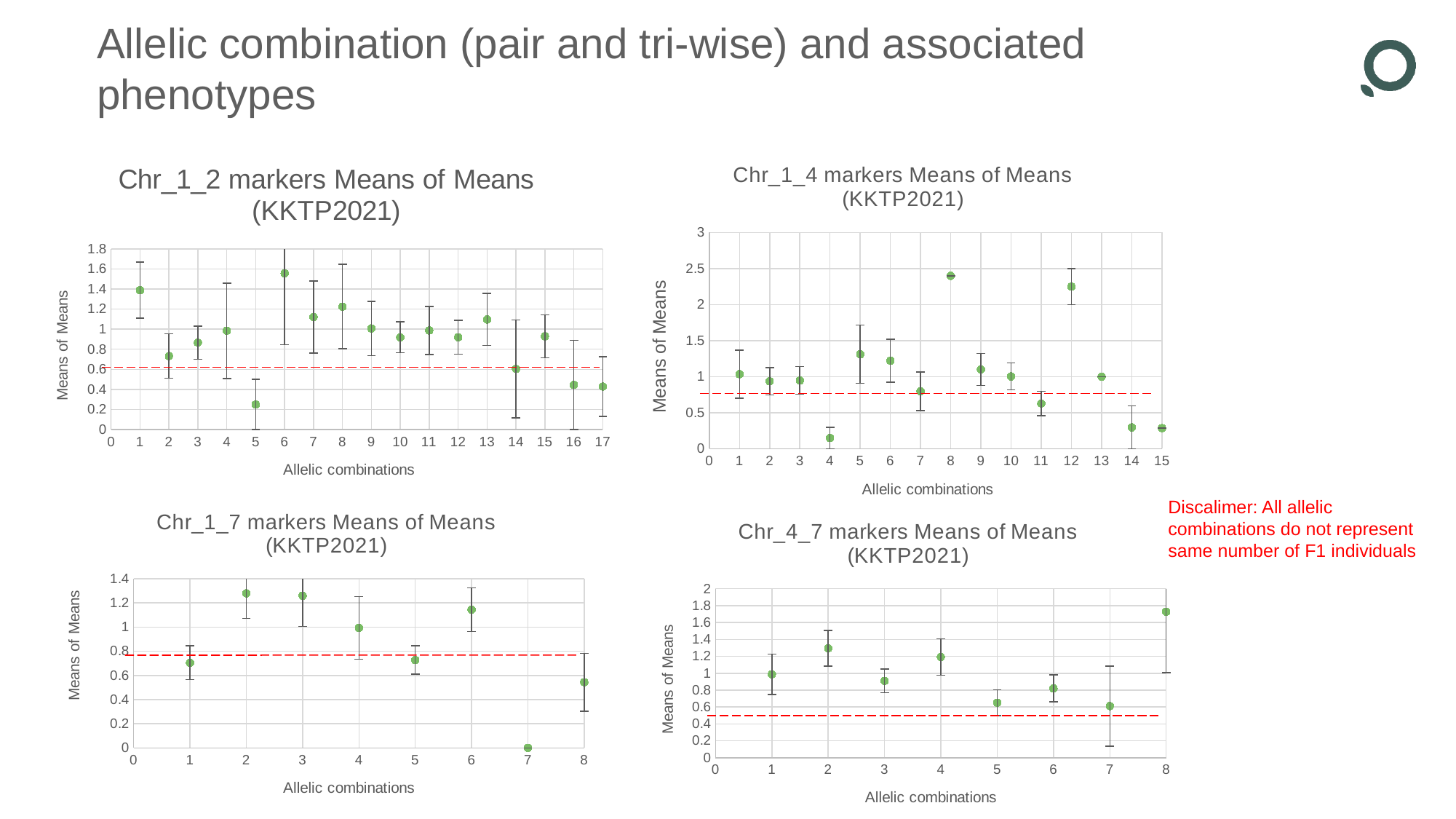
What kind of chart is the Chr_1_2 markers Means of Means (KKTP2021) chart? scatter chart How many allelic combinations are plotted in the Chr_1_7 markers Means of Means (KKTP2021) chart? 8 How many allelic combinations are plotted in the Chr_1_4 markers Means of Means (KKTP2021) chart? 15 In the Chr_1_4 markers Means of Means (KKTP2021) chart, is the value for allelic combination 8 greater or less than 2? greater In the Chr_1_2 markers Means of Means (KKTP2021) chart, which allelic combination has the lowest mean of means? 5 What is the y-axis label on the Chr_4_7 markers Means of Means (KKTP2021) chart? Means of Means In the Chr_1_4 markers Means of Means (KKTP2021) chart, which allelic combination has the lowest mean of means? 4 How many allelic combinations are plotted in the Chr_1_2 markers Means of Means (KKTP2021) chart? 17 In the Chr_4_7 markers Means of Means (KKTP2021) chart, is the value for allelic combination 2 greater or less than 1.2? greater In the Chr_1_2 markers Means of Means (KKTP2021) chart, is the value for allelic combination 1 greater or less than 1? greater In the Chr_1_7 markers Means of Means (KKTP2021) chart, which allelic combination has the lowest mean of means? 7 In the Chr_4_7 markers Means of Means (KKTP2021) chart, which allelic combination has the highest mean of means? 8